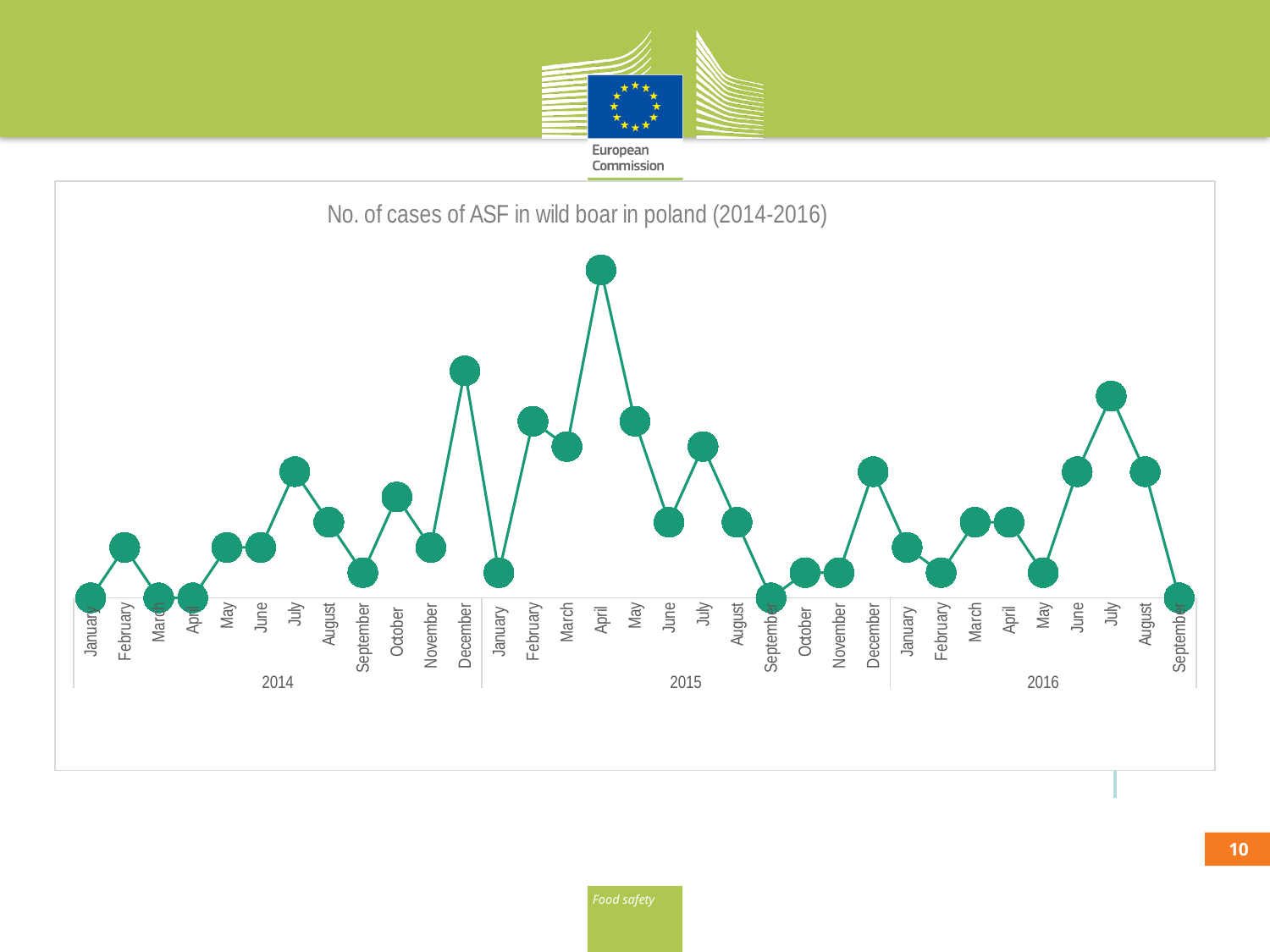
Which is larger, the value for December 2014 or the value for November 2014? December 2014 In which month and year does the chart show the highest number of ASF cases in wild boar? April 2015 How many monthly data points are plotted on the chart? 33 What kind of chart is shown on the slide? Line chart Which is larger, the value for July 2016 or the value for February 2016? July 2016 How many years are shown along the x axis of the chart? 3 Which is larger, the value for April 2015 or the value for December 2014? April 2015 Which month in 2014 has the highest number of cases? December Do the values rise or fall from April 2015 to September 2015? Fall Do the values rise or fall from May 2016 to July 2016? Rise What is the title of the chart? No. of cases of ASF in wild boar in poland (2014-2016) Which month in 2016 has the highest number of cases? July